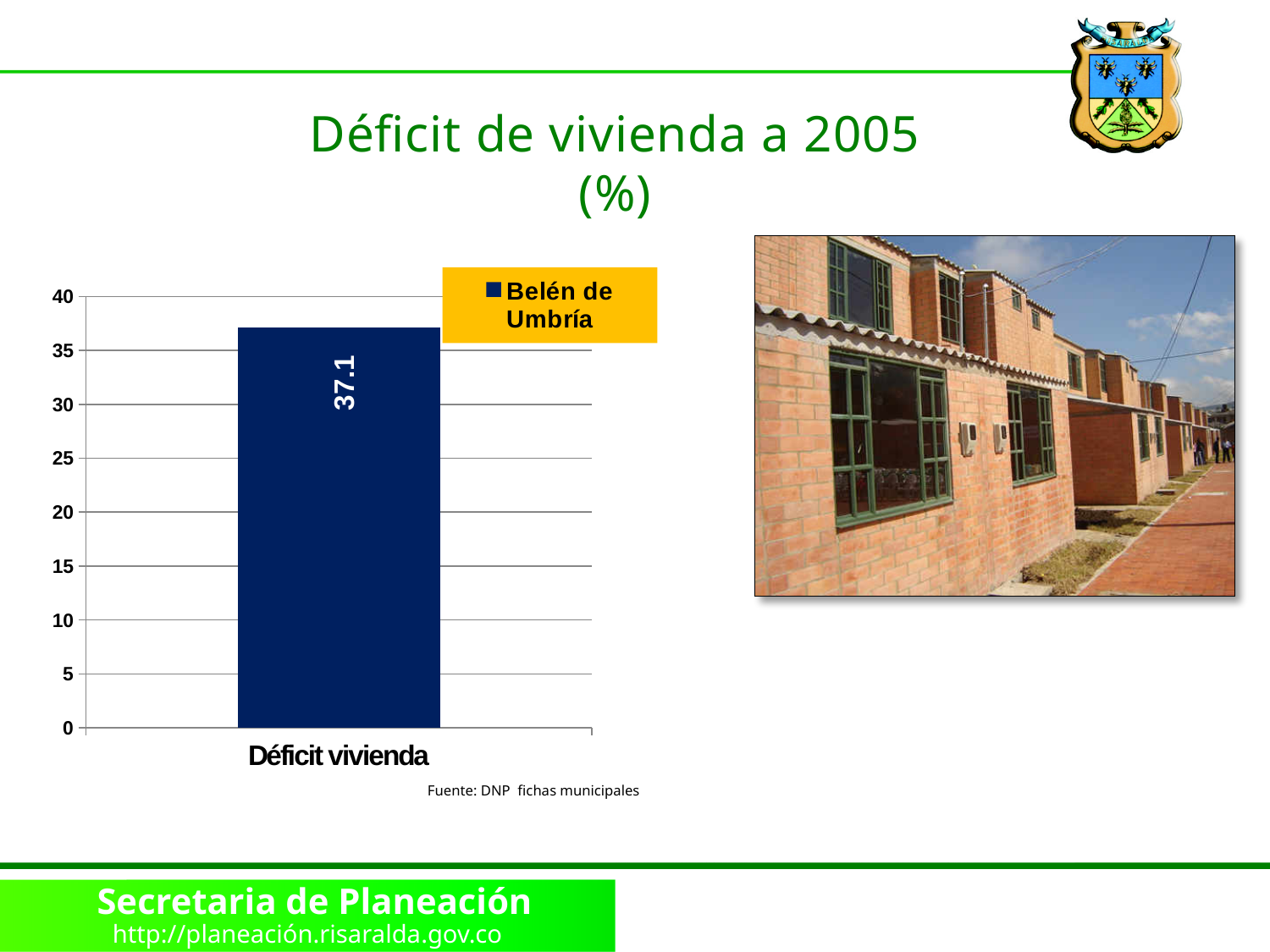
How many bars are plotted in the chart? 1 What series name appears in the chart legend? Belén de Umbría Is the value for Déficit vivienda greater or less than 40? less What is the value of the Déficit vivienda bar for Belén de Umbría? 37.1 What is the highest value shown on the chart's y axis? 40 What is the category label shown on the x axis of the chart? Déficit vivienda How many series does the legend list? 1 What kind of chart is shown on the slide? bar chart Is the value for Déficit vivienda greater or less than 35? greater